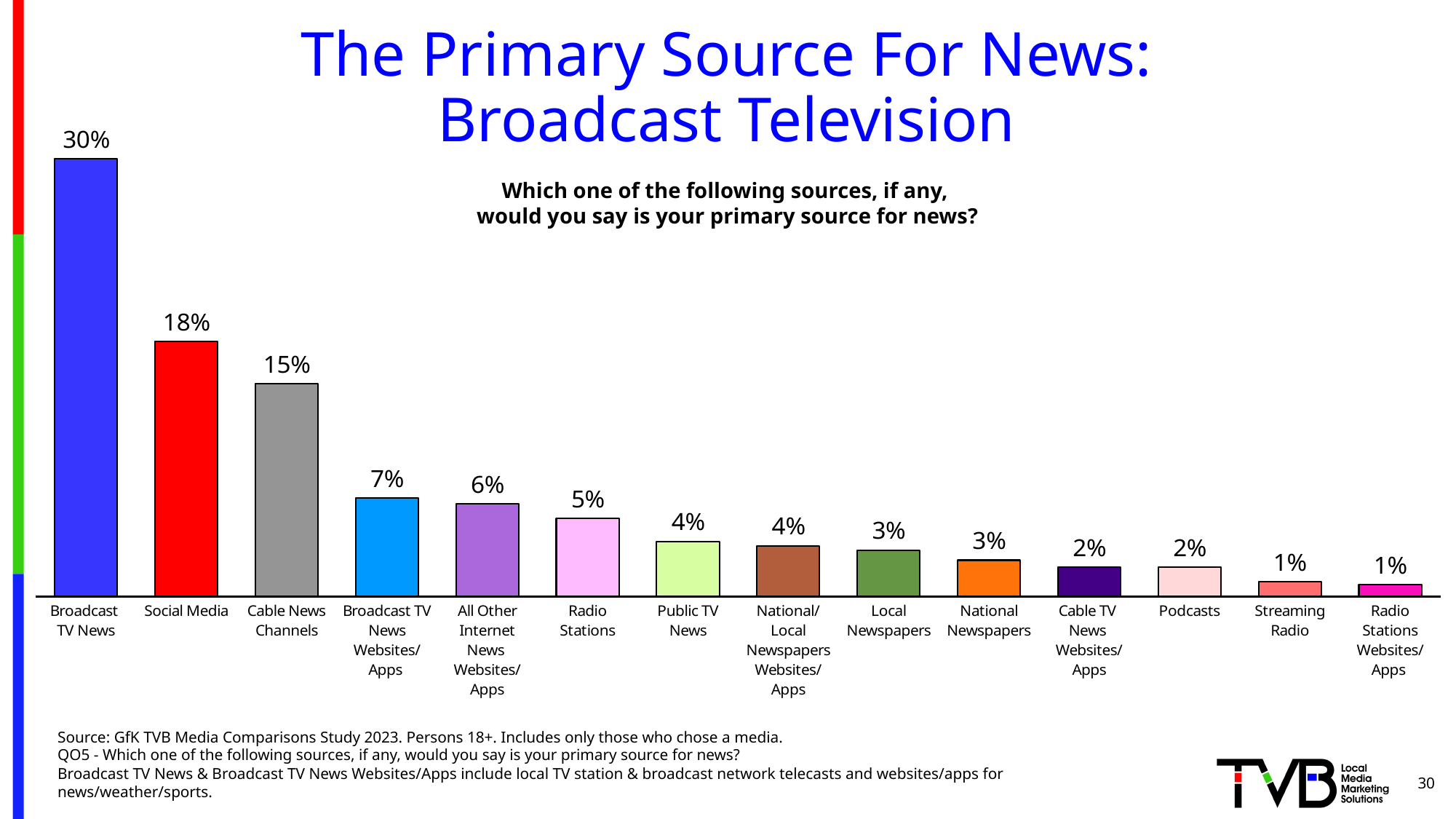
Do the values rise or fall moving from left to right across the chart? Fall What is the value shown for Social Media? 18% What kind of chart is shown on the slide? Bar chart Which is larger, the value for Radio Stations or the value for Public TV News? Radio Stations What is the value for Podcasts? 2% How many news sources are shown as bars in the chart? 14 Which source has the highest percentage in the chart? Broadcast TV News What percentage of respondents named Broadcast TV News as their primary source for news? 30% Which is larger, the value for Social Media or the value for Cable News Channels? Social Media What percentage is shown for Cable News Channels? 15% What is the difference between the values for Cable News Channels and Broadcast TV News Websites/Apps? 8% What is the difference between the values for Broadcast TV News and Social Media? 12%